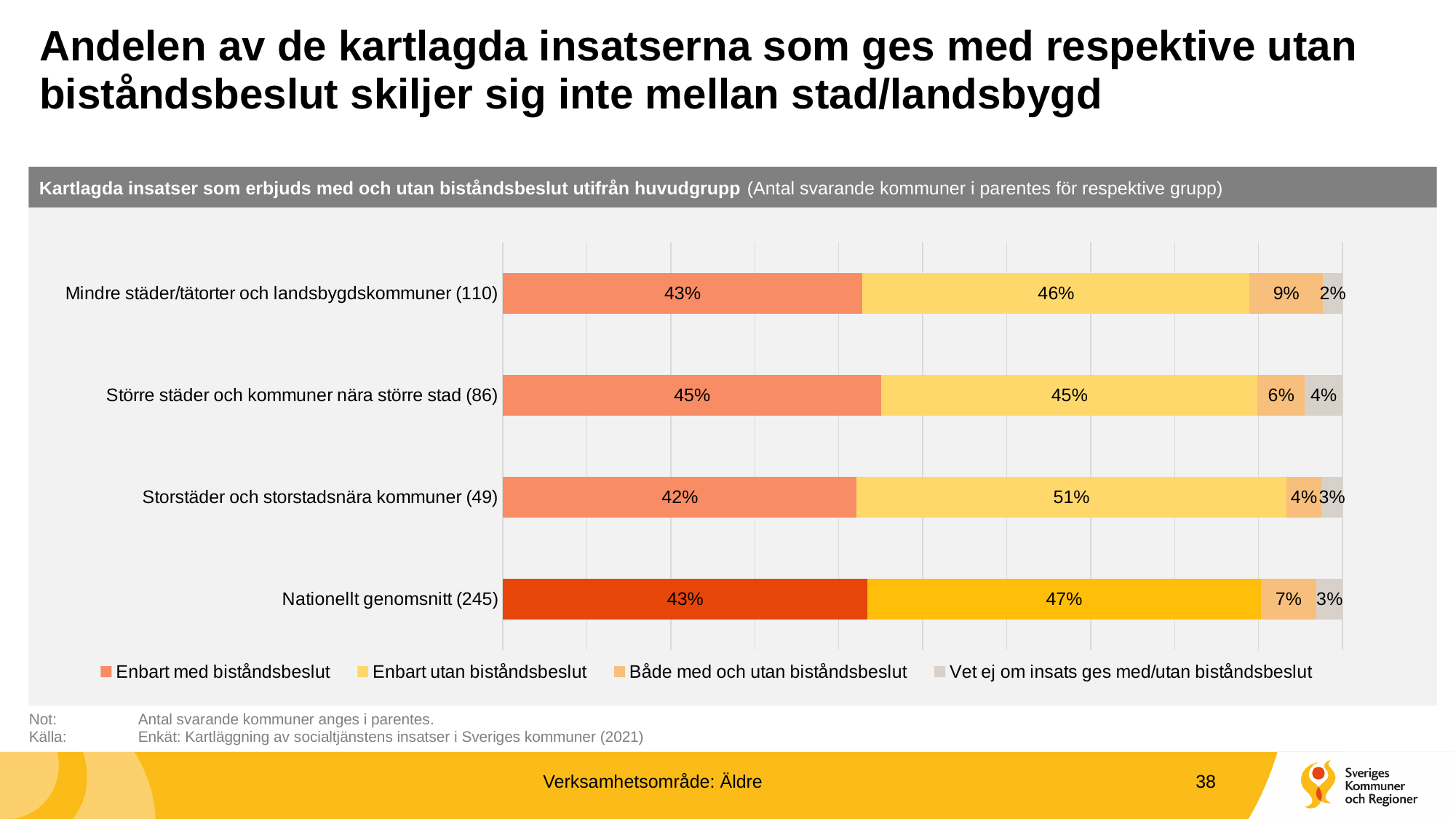
Which group has the lowest value for 'Enbart med biståndsbeslut'? Storstäder och storstadsnära kommuner (49) What is the value of 'Enbart utan biståndsbeslut' for 'Nationellt genomsnitt (245)'? 47% What kind of chart is shown on the slide? Stacked bar chart Which legend entry is shown in grey? Vet ej om insats ges med/utan biståndsbeslut What is the value of 'Både med och utan biståndsbeslut' for 'Mindre städer/tätorter och landsbygdskommuner (110)'? 9% How many series does the legend list? 4 What is the value of 'Enbart med biståndsbeslut' for 'Större städer och kommuner nära större stad (86)'? 45% Which group has the highest value for 'Enbart utan biståndsbeslut'? Storstäder och storstadsnära kommuner (49) Which is larger: 'Enbart utan biståndsbeslut' for 'Storstäder och storstadsnära kommuner (49)' or for 'Mindre städer/tätorter och landsbygdskommuner (110)'? Storstäder och storstadsnära kommuner (49) What is the total of the stacked bar for 'Mindre städer/tätorter och landsbygdskommuner (110)'? 100% How many groups (categories) are plotted in the chart? 4 For 'Storstäder och storstadsnära kommuner (49)', what is the difference between 'Enbart utan biståndsbeslut' and 'Enbart med biståndsbeslut'? 9 percentage points